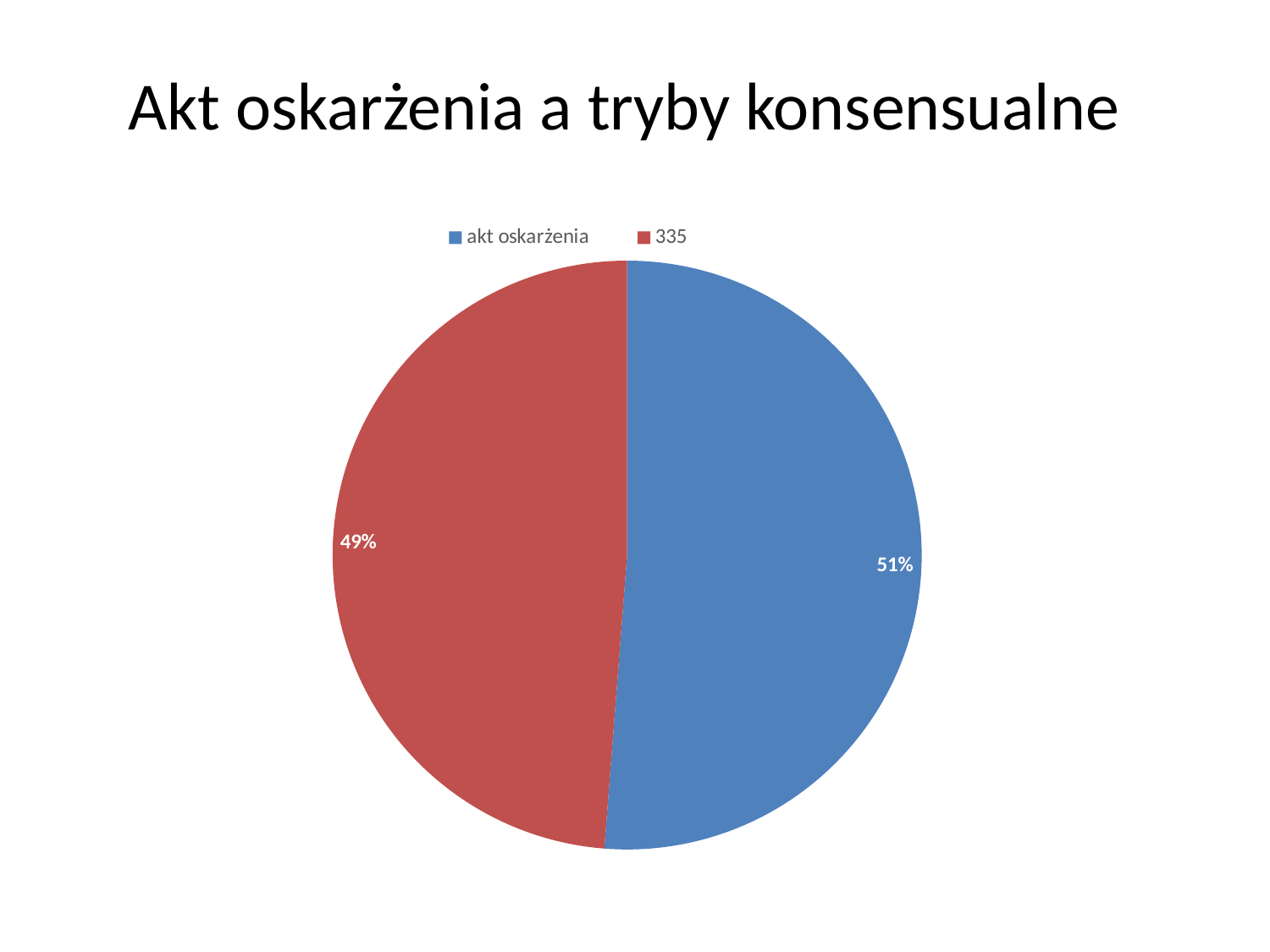
How many slices does the pie chart have? 2 What is the difference in percentage points between the "akt oskarżenia" slice and the "335" slice? 2 percentage points Which slice is the smallest in the pie chart? 335 Which slice is larger, "akt oskarżenia" or "335"? akt oskarżenia What kind of chart is shown on the slide? pie chart Which slice is the largest in the pie chart? akt oskarżenia What share of the pie does the "335" slice represent? 49% What colour is the "akt oskarżenia" slice? blue What is the title of the slide? Akt oskarżenia a tryby konsensualne How many entries does the legend list? 2 What share of the pie does the "akt oskarżenia" slice represent? 51%